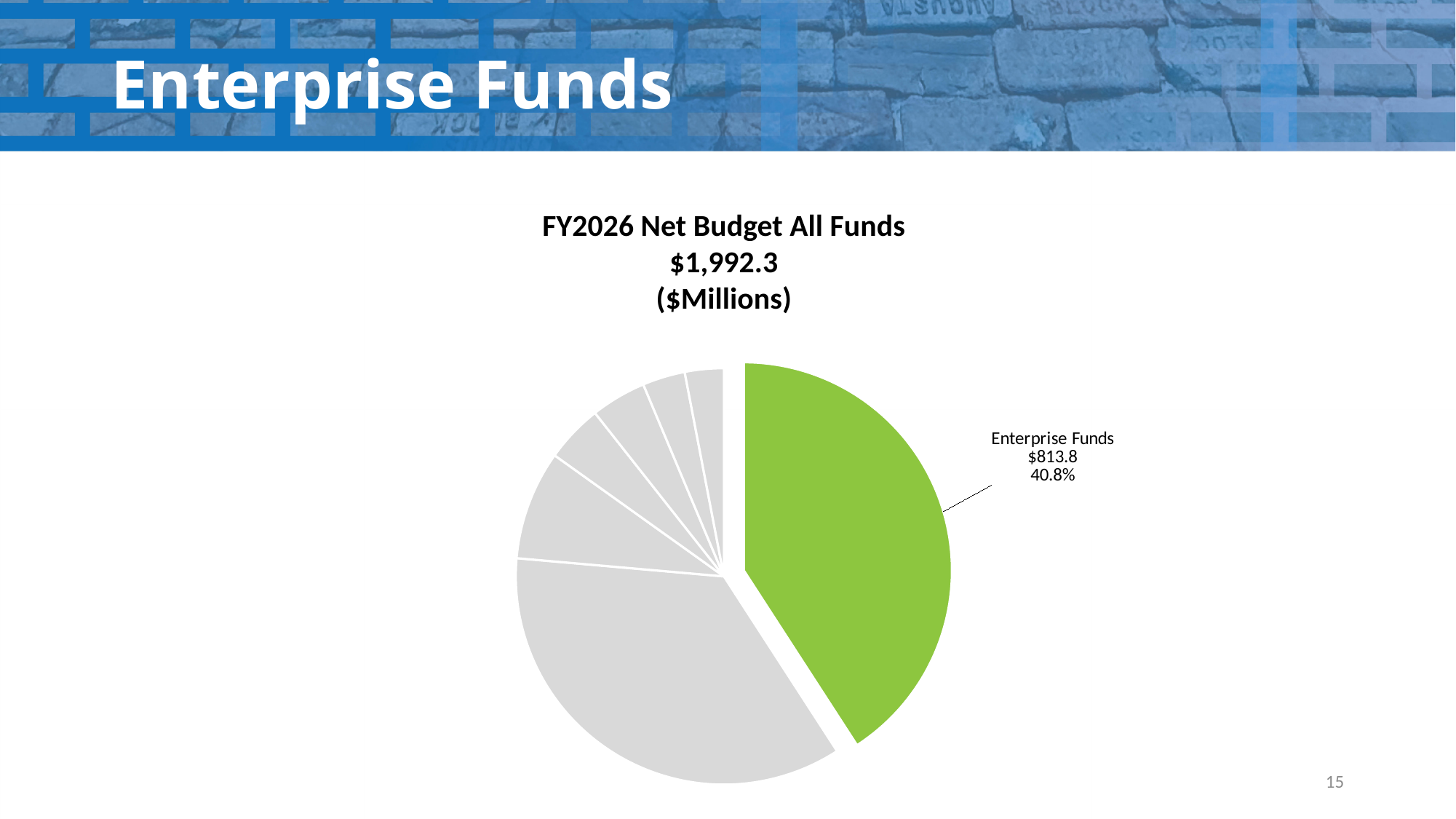
How much of the $1,992.3 total is not Enterprise Funds? $1,178.5 What kind of chart is shown on the slide? Pie chart What is the value shown for the Enterprise Funds slice? $813.8 What is the total FY2026 Net Budget All Funds shown in the chart title? $1,992.3 What is the title of the chart? FY2026 Net Budget All Funds $1,992.3 ($Millions) What percentage of the pie does the Enterprise Funds slice represent? 40.8% Is the Enterprise Funds share of the pie greater or less than 50%? less In what units are the chart values expressed? $Millions What colour is the Enterprise Funds slice? Green Which slice of the pie is labeled with a value? Enterprise Funds